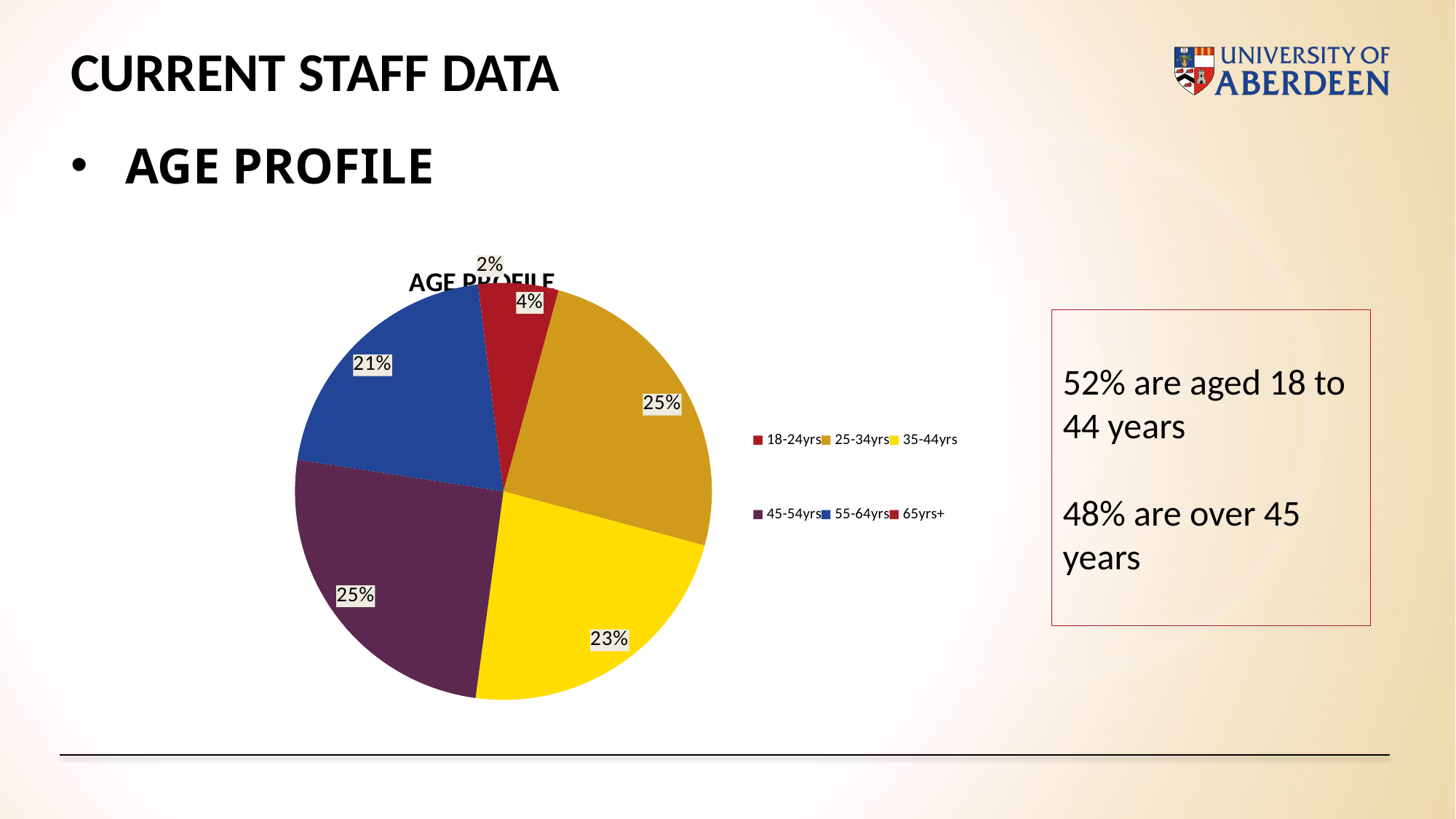
What percentage of staff are aged 25-34yrs? 25% What is the combined share of the 18-24yrs, 25-34yrs and 35-44yrs groups? 52% What is the title of the chart? AGE PROFILE Which age group has the smallest share of the pie? 65yrs+ What type of chart is shown on the slide? pie chart Which is larger, the share for 35-44yrs or the share for 55-64yrs? 35-44yrs How many age groups does the legend list? 6 What colour is the slice for 55-64yrs? blue What percentage of staff are aged 55-64yrs? 21% What percentage of staff are aged 18-24yrs? 4% What is the difference between the share for 25-34yrs and the share for 35-44yrs? 2% What percentage of staff are aged 35-44yrs? 23%